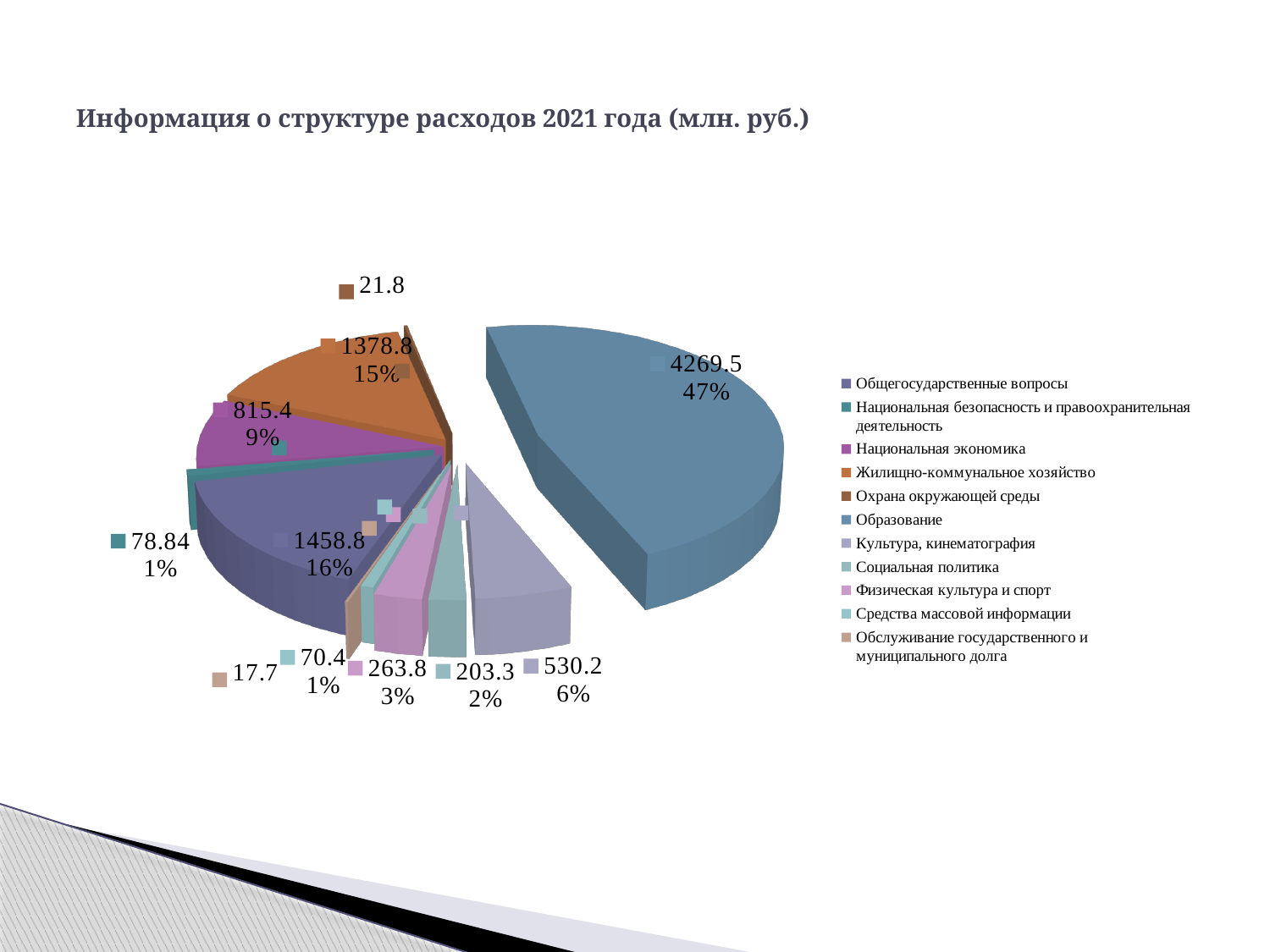
What share of the pie does Образование represent? 47% What is the value for Жилищно-коммунальное хозяйство? 1378.8 Which is larger, the value for Национальная экономика or the value for Культура, кинематография? Национальная экономика What kind of chart is shown on the slide? pie chart What is the title of the chart? Информация о структуре расходов 2021 года (млн. руб.) What is the difference between the values for Общегосударственные вопросы and Жилищно-коммунальное хозяйство? 80 What share of the pie does Общегосударственные вопросы represent? 16% What is the value for Образование? 4269.5 Which category has the largest slice? Образование Which category has the smallest value? Обслуживание государственного и муниципального долга How many categories does the legend list? 11 What is the value for Национальная безопасность и правоохранительная деятельность? 78.84